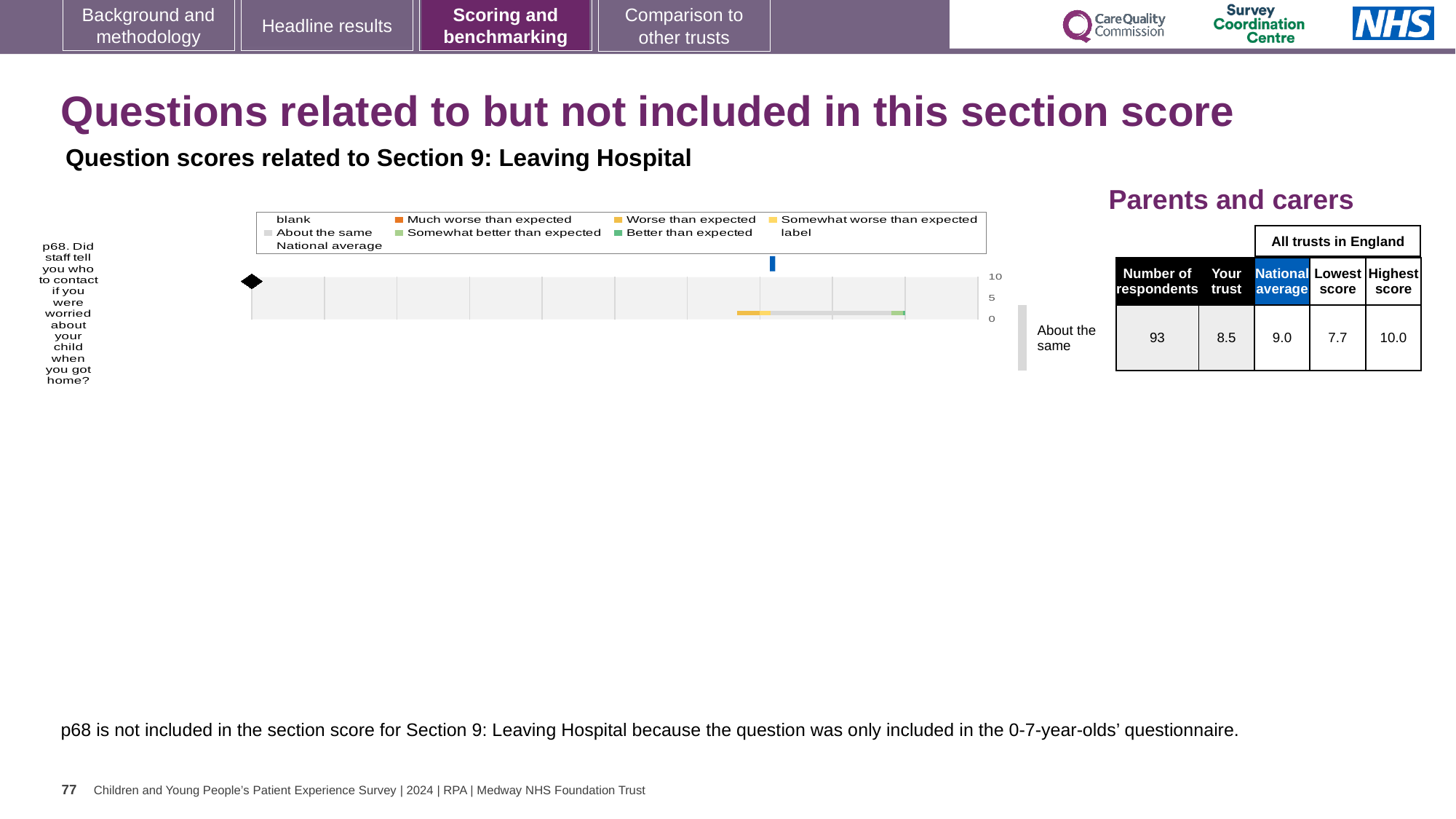
Which is larger for question p68, the 'Your trust' score or the national average? National average How many respondents answered question p68? 93 How is the trust's result for question p68 categorised relative to expectation? About the same What is the national average score for question p68? 9.0 What kind of chart is used to show the p68 question score? bar chart What is the 'Your trust' score for question p68? 8.5 What is the difference between the national average and the 'Your trust' score for question p68? 0.5 How many questions are plotted in the chart? 1 What is the difference between the highest and lowest scores among all trusts in England for question p68? 2.3 What is the highest score among all trusts in England for question p68? 10.0 How many entries does the chart legend list? 9 What is the lowest score among all trusts in England for question p68? 7.7